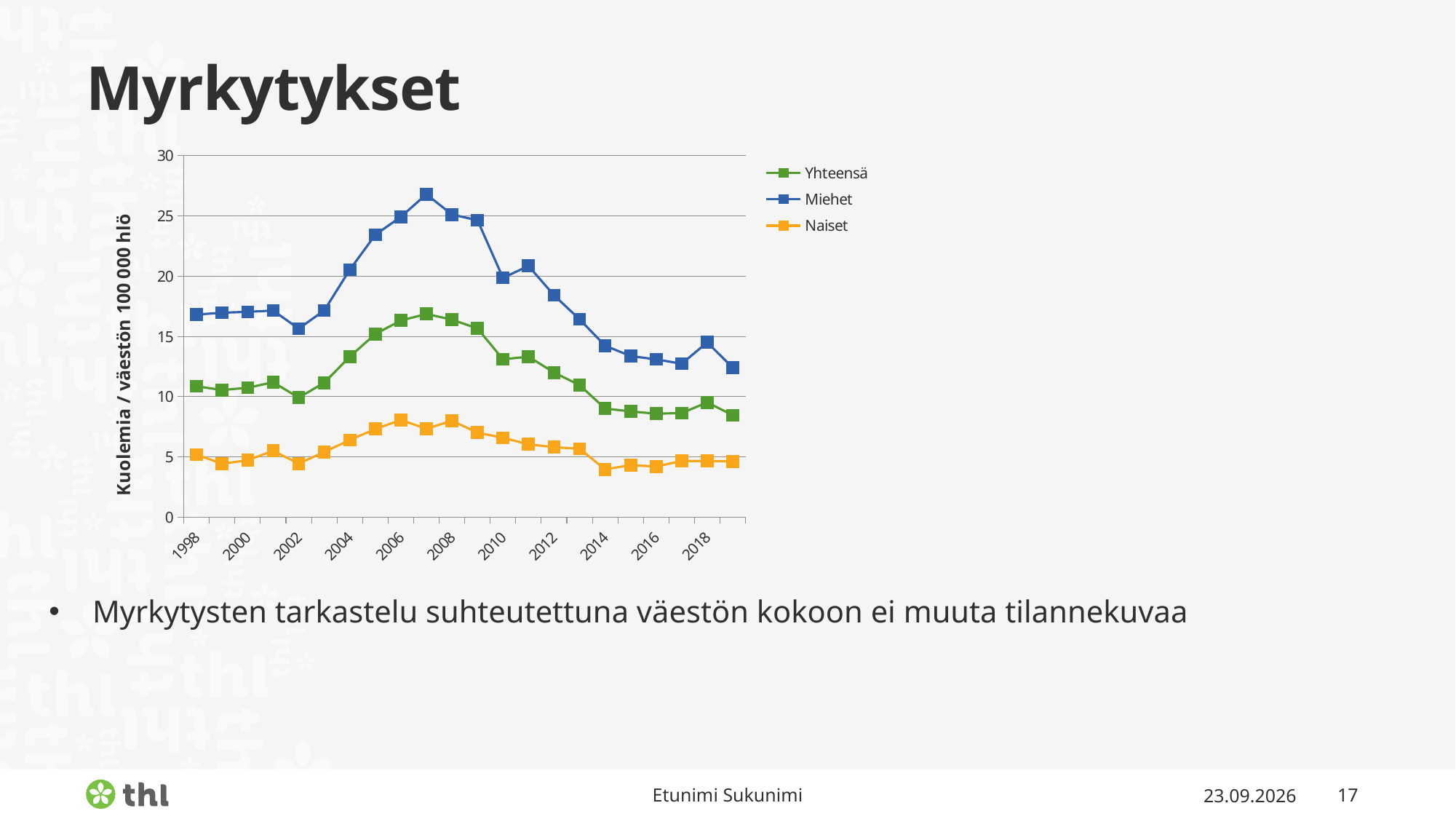
Is the value for Miehet in 2007 greater or less than 25? greater In which year does the Miehet series reach its highest value? 2007 Is the value for Yhteensä in 2019 greater or less than 10? less Is the value for Naiset in 2014 greater or less than 5? less How many series does the legend list? 3 Which series has the higher value in 2007, Miehet or Naiset? Miehet What kind of chart is shown on the slide? Line chart In which year does the Yhteensä series reach its highest value? 2007 What is the label on the vertical axis of the chart? Kuolemia / väestön 100 000 hlö Which series are listed in the chart legend? Yhteensä, Miehet, Naiset Does the Miehet series rise or fall between 2007 and 2014? Fall